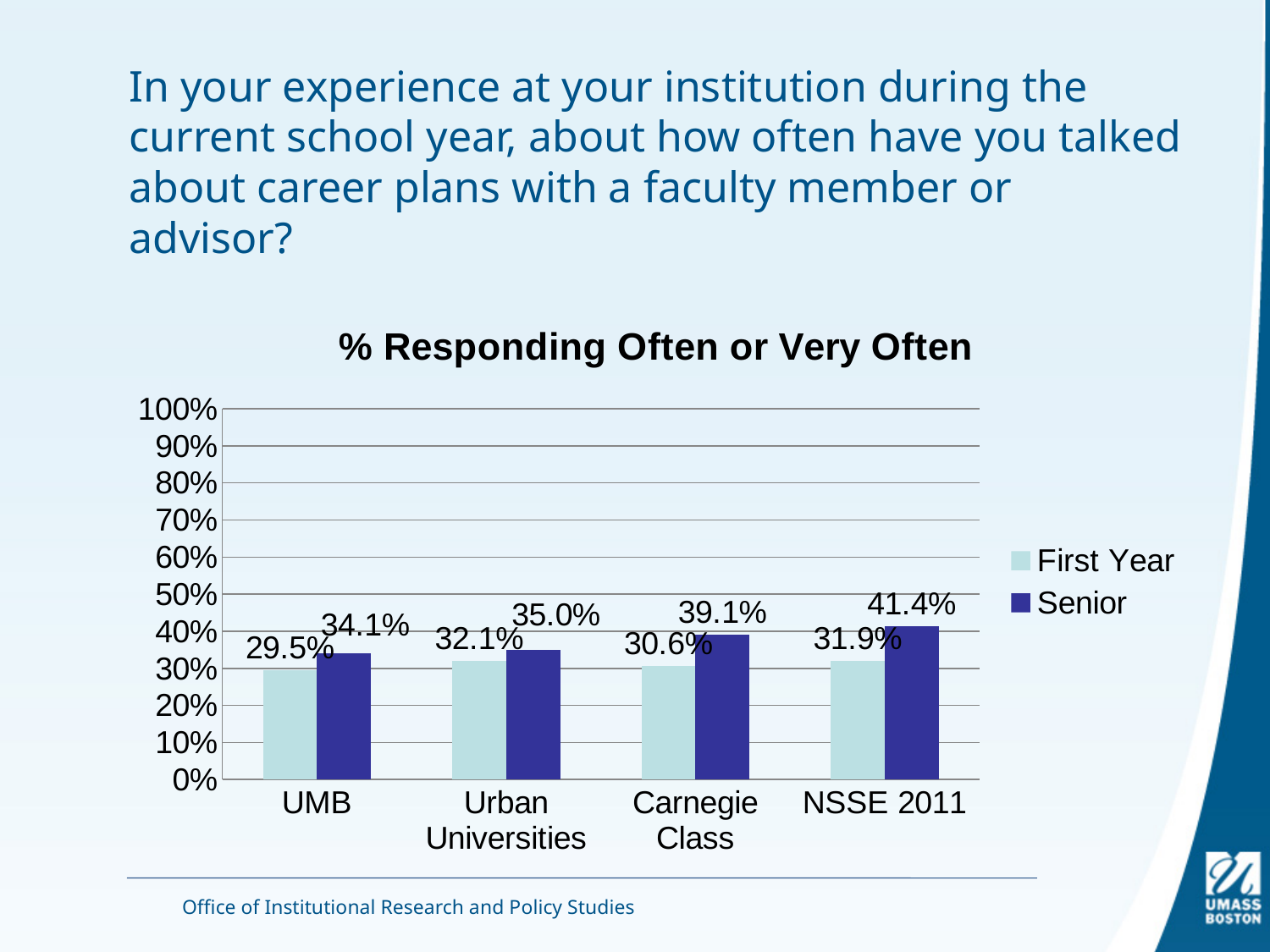
What kind of chart is shown? bar chart Which category has the lowest First Year value? UMB What is the Senior value for NSSE 2011? 41.4% What is the First Year value for UMB? 29.5% Is the First Year value for NSSE 2011 greater or less than 40%? less How many categories are shown on the x axis? 4 What is the difference between the Senior and First Year values for Carnegie Class? 8.5% What is the Senior value for Carnegie Class? 39.1% Which is larger, the Senior value for UMB or the Senior value for Urban Universities? Urban Universities How many series does the legend list? 2 Which category has the highest Senior value? NSSE 2011 What is the First Year value for Urban Universities? 32.1%